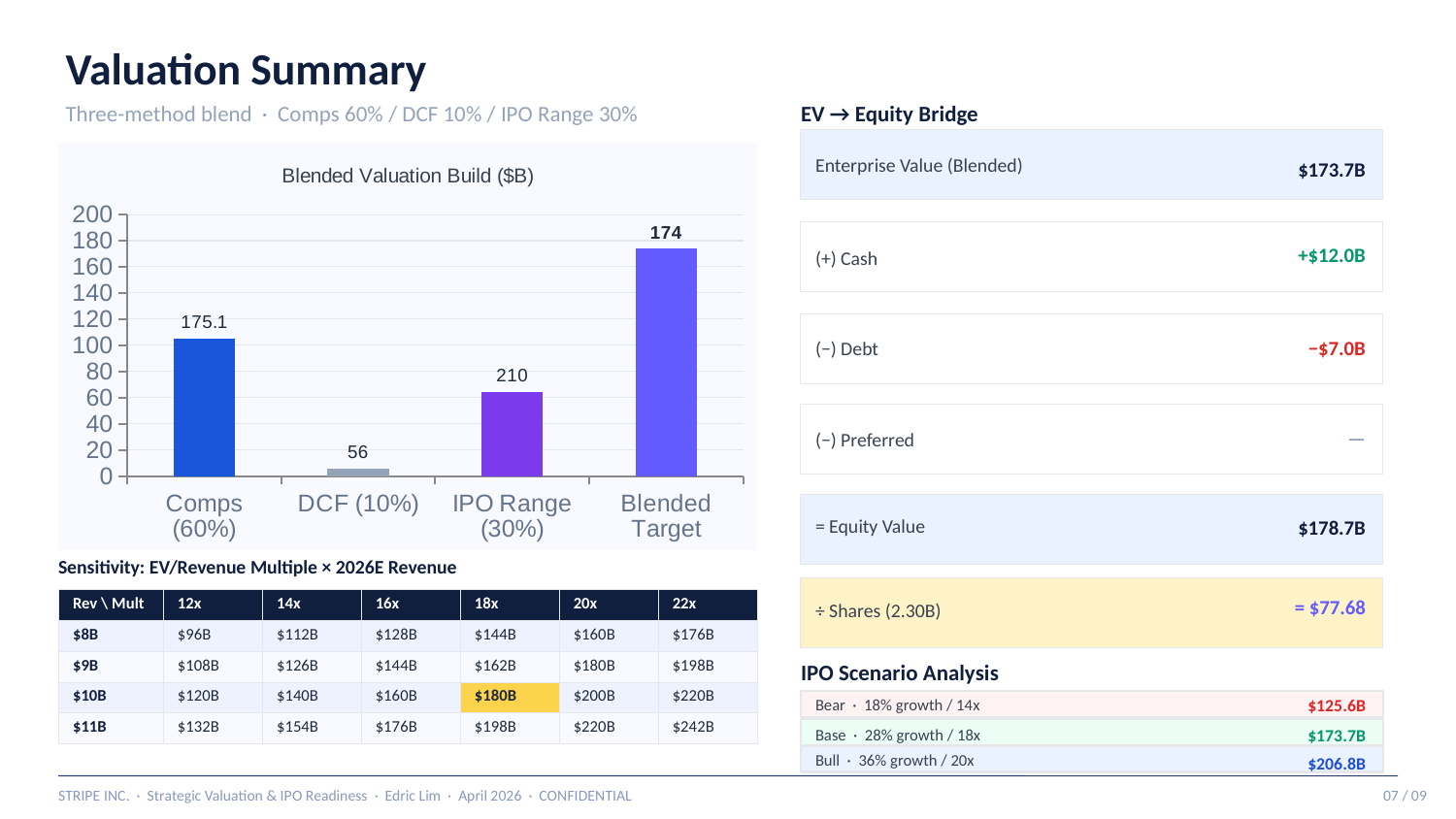
Is the value for Blended Target greater or less than 140? greater How many categories are shown on the x axis of the Blended Valuation Build chart? 4 What is the difference between the labelled values for Blended Target and DCF (10%)? 118 Which is larger, the value for DCF (10%) or the value for Blended Target? Blended Target What kind of chart is the Blended Valuation Build chart? Bar chart What is the title of the chart on the slide? Blended Valuation Build ($B) What value is labelled on the IPO Range (30%) bar? 210 What value is labelled on the DCF (10%) bar? 56 What is the data label on the Comps (60%) bar in the Blended Valuation Build chart? 175.1 Which category has the lowest value in the Blended Valuation Build chart? DCF (10%) What value is labelled on the Blended Target bar? 174 Is the value for DCF (10%) greater or less than 100? less